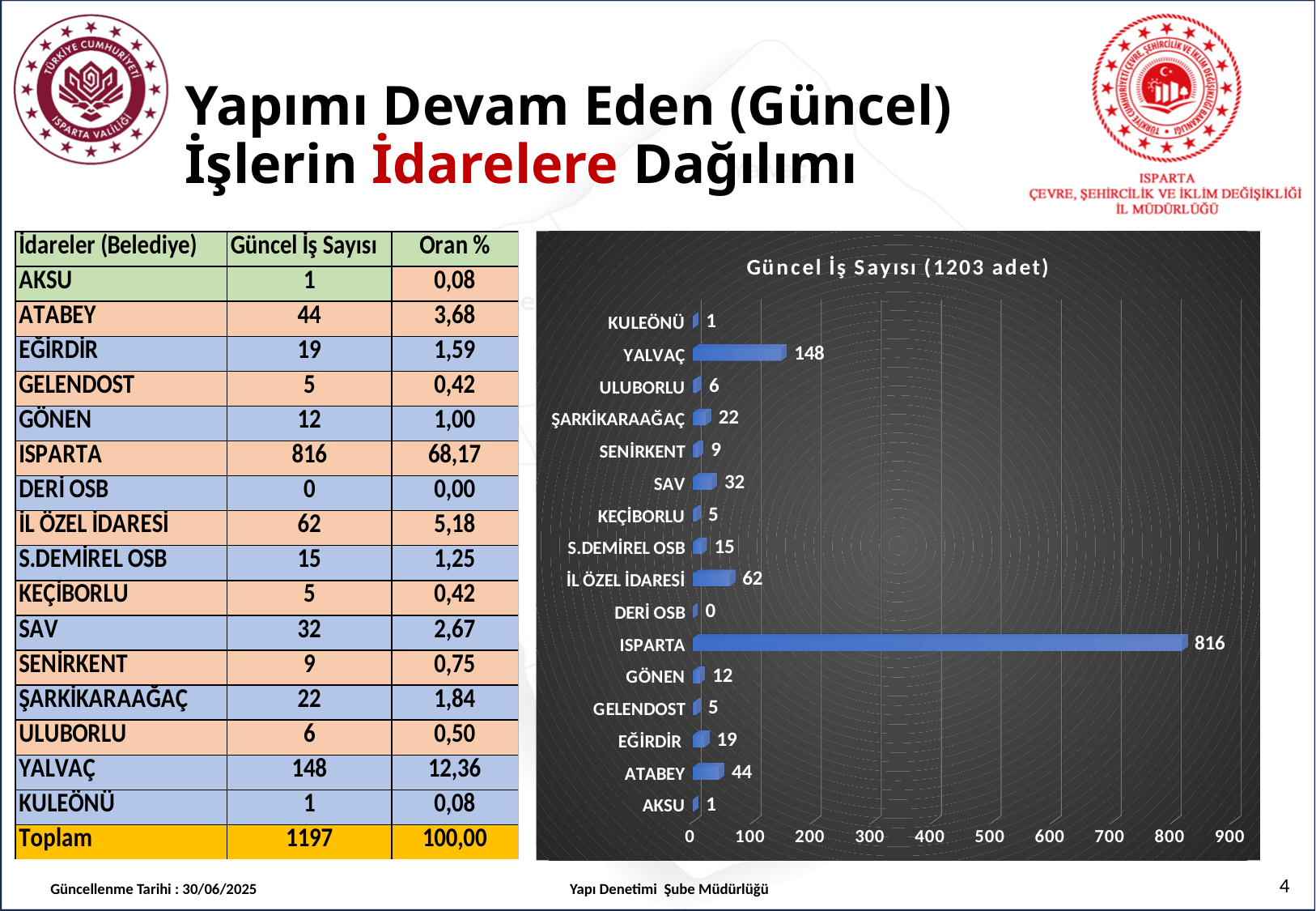
What is the value for SAV in the chart? 32 What kind of chart is shown on the slide? bar chart What is the difference between the values for ATABEY and ŞARKİKARAAĞAÇ? 22 Which is larger, the value for SAV or the value for EĞİRDİR? SAV What is the value for İL ÖZEL İDARESİ in the chart? 62 What is the value for YALVAÇ in the chart? 148 What is the title of the chart? Güncel İş Sayısı (1203 adet) How many categories are shown in the chart? 16 What is the difference between the values for ISPARTA and YALVAÇ? 668 Is the value for ISPARTA greater or less than 800? greater Which category has the lowest value in the chart? DERİ OSB Which category has the highest value in the chart? ISPARTA